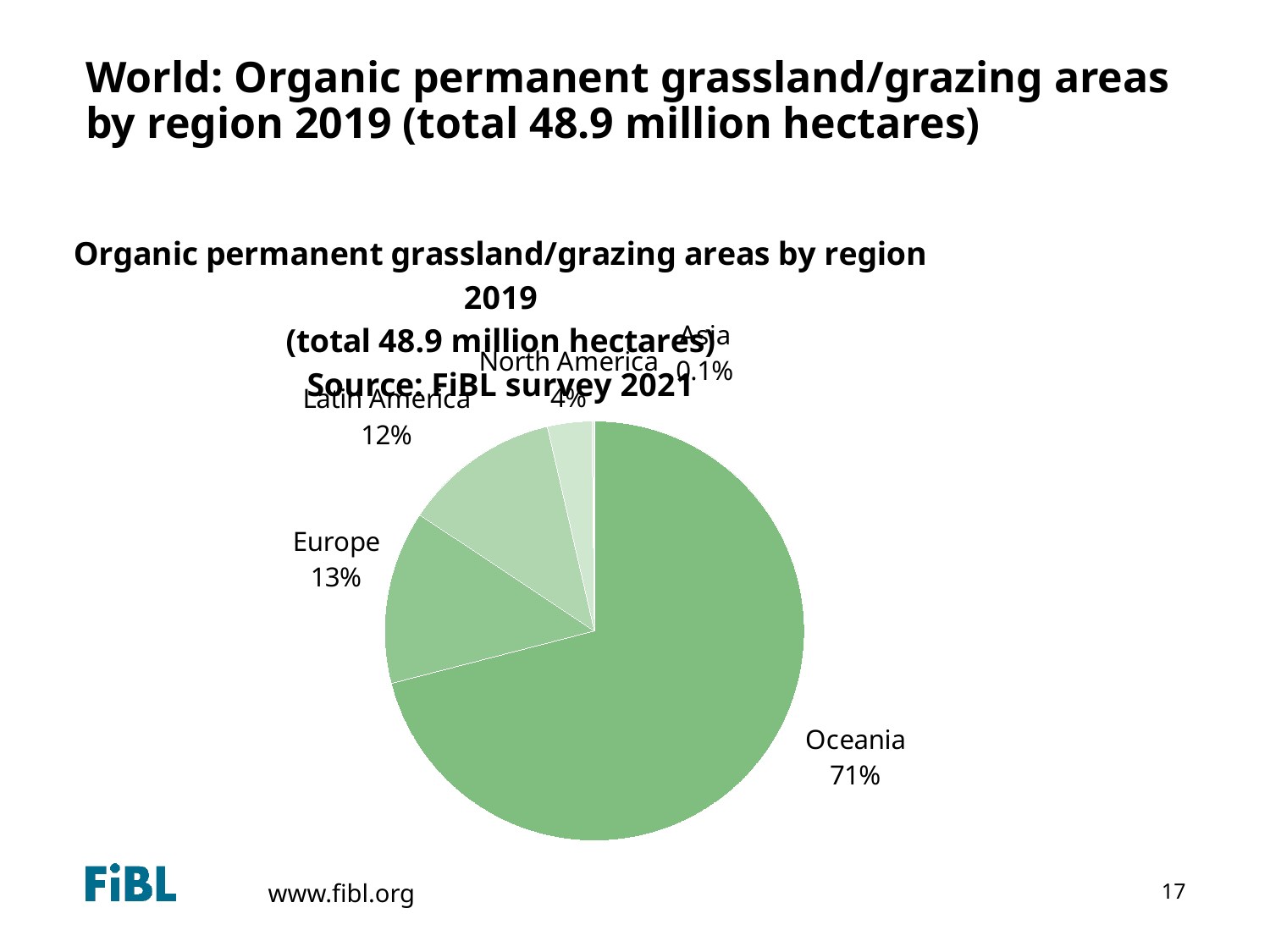
What is the value shown for Asia? 0.1% Which region has the smallest slice of the pie? Asia What share of the pie does Oceania hold? 71% How many regions are shown in the pie chart? 5 What is the value shown for Europe? 13% Which region has the largest slice of the pie? Oceania What total area in hectares does the chart title state? 48.9 million hectares What kind of chart is shown on the slide? Pie chart What is the difference in percentage points between Oceania and Europe? 58 What is the value shown for Latin America? 12% Which is larger, the share for Europe or the share for North America? Europe What is the value shown for North America? 4%